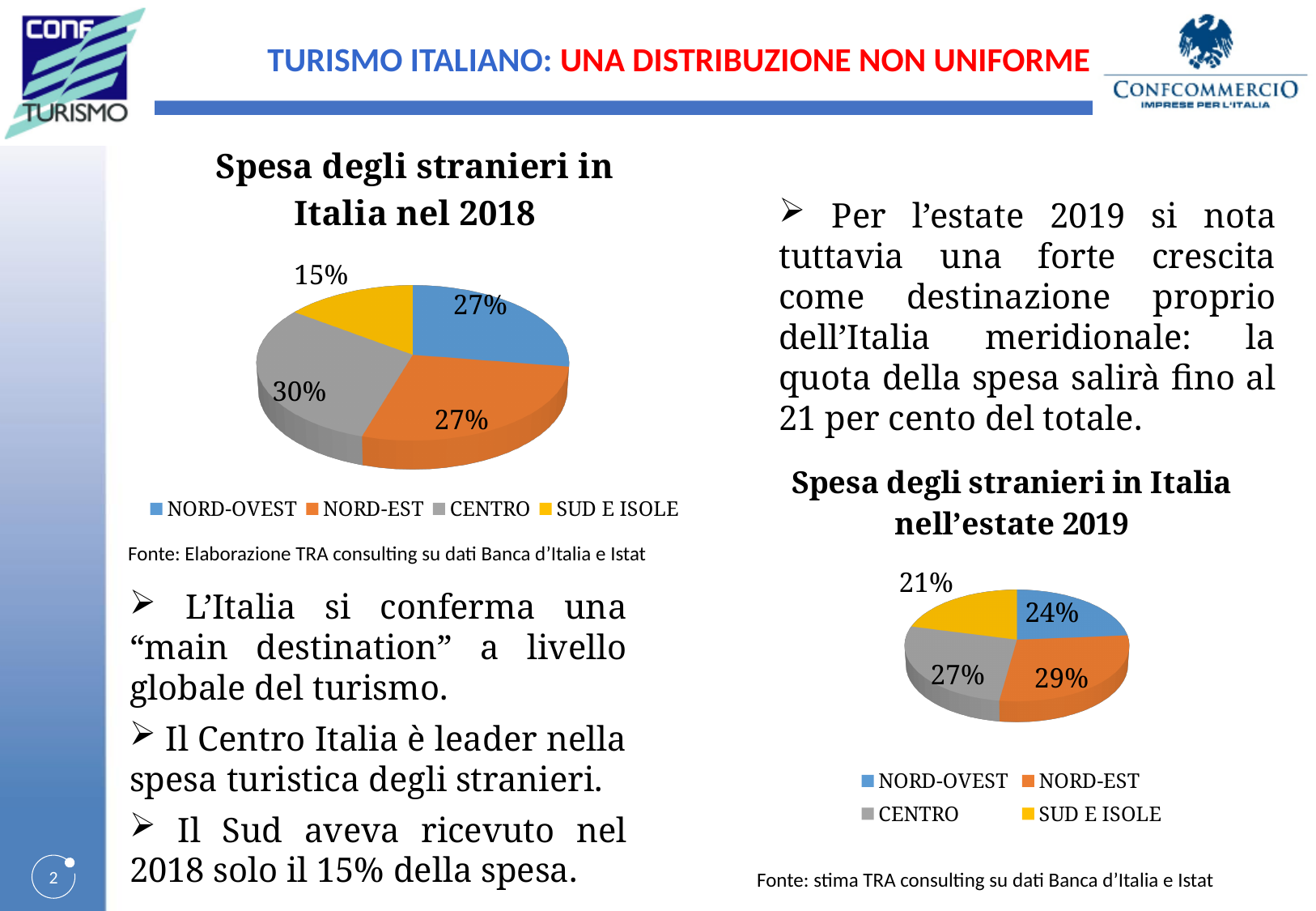
In the chart 'Spesa degli stranieri in Italia nel 2018', which colour represents SUD E ISOLE? Yellow In the chart 'Spesa degli stranieri in Italia nel 2018', what is the difference between the shares of CENTRO and SUD E ISOLE? 15 percentage points In the chart 'Spesa degli stranieri in Italia nell'estate 2019', what share does NORD-EST have? 29% What type of chart is 'Spesa degli stranieri in Italia nel 2018'? Pie chart In the chart 'Spesa degli stranieri in Italia nell'estate 2019', what share does SUD E ISOLE have? 21% In the chart 'Spesa degli stranieri in Italia nel 2018', which region has the largest share? CENTRO In the chart 'Spesa degli stranieri in Italia nel 2018', what share does CENTRO have? 30% In the chart 'Spesa degli stranieri in Italia nel 2018', what share does SUD E ISOLE have? 15% In the chart 'Spesa degli stranieri in Italia nel 2018', which region has the smallest share? SUD E ISOLE In the chart 'Spesa degli stranieri in Italia nell'estate 2019', which region has the largest share? NORD-EST How many slices does the chart 'Spesa degli stranieri in Italia nell'estate 2019' have? 4 In the chart 'Spesa degli stranieri in Italia nell'estate 2019', which is larger, the share of NORD-OVEST or the share of CENTRO? CENTRO